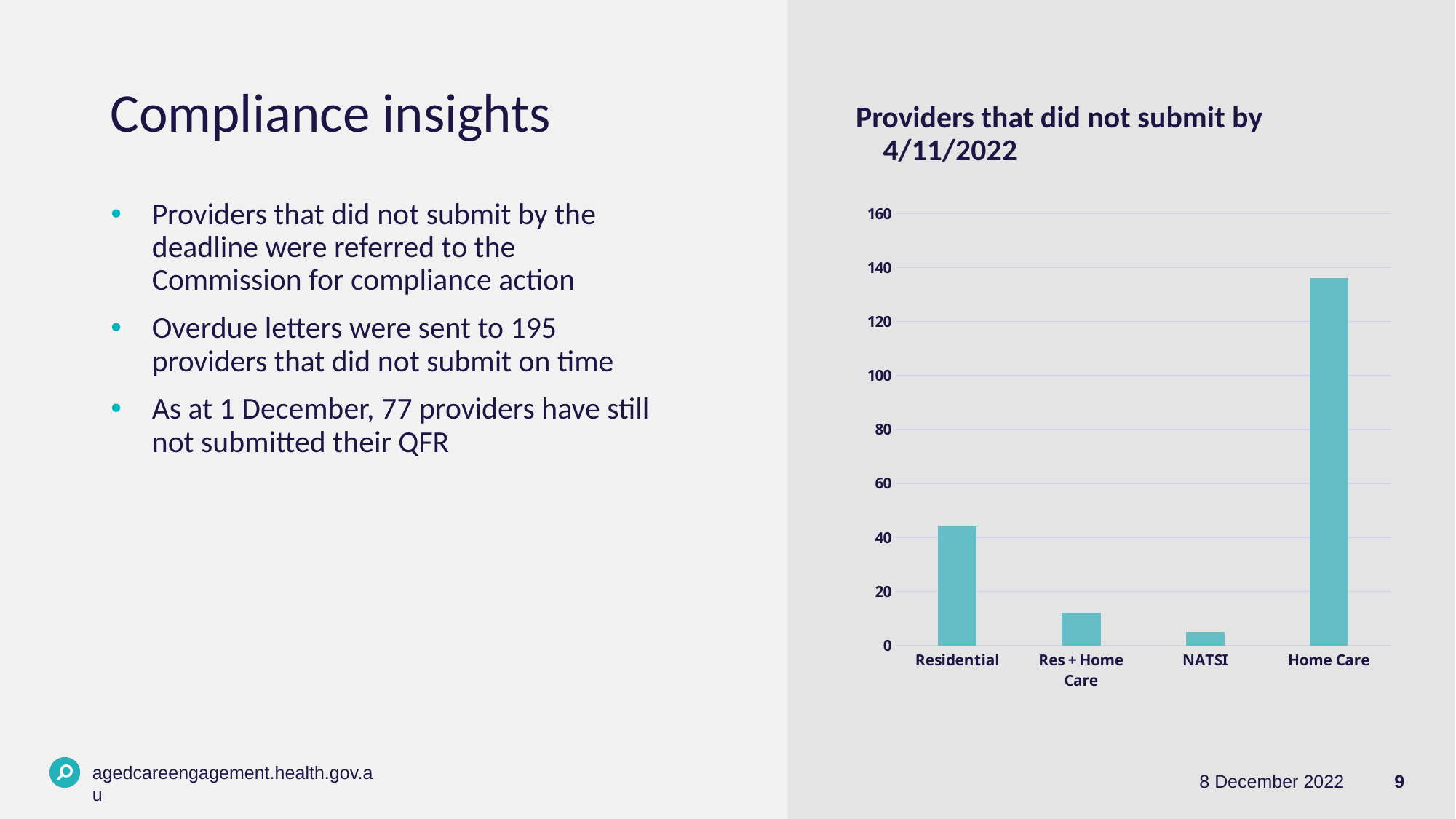
What is the highest value shown on the chart's vertical axis? 160 Is the value for Residential greater or less than 60? less Which category has the highest number of providers that did not submit by 4/11/2022? Home Care Is the value for NATSI greater or less than 20? less Which is larger, the value for Home Care or the value for Residential? Home Care What is the title of the chart? Providers that did not submit by 4/11/2022 Is the value for Res + Home Care greater or less than 20? less How many categories are shown on the x axis of the chart? 4 What kind of chart is shown on the slide? bar chart Which category has the lowest number of providers that did not submit by 4/11/2022? NATSI Which is larger, the value for Residential or the value for Res + Home Care? Residential